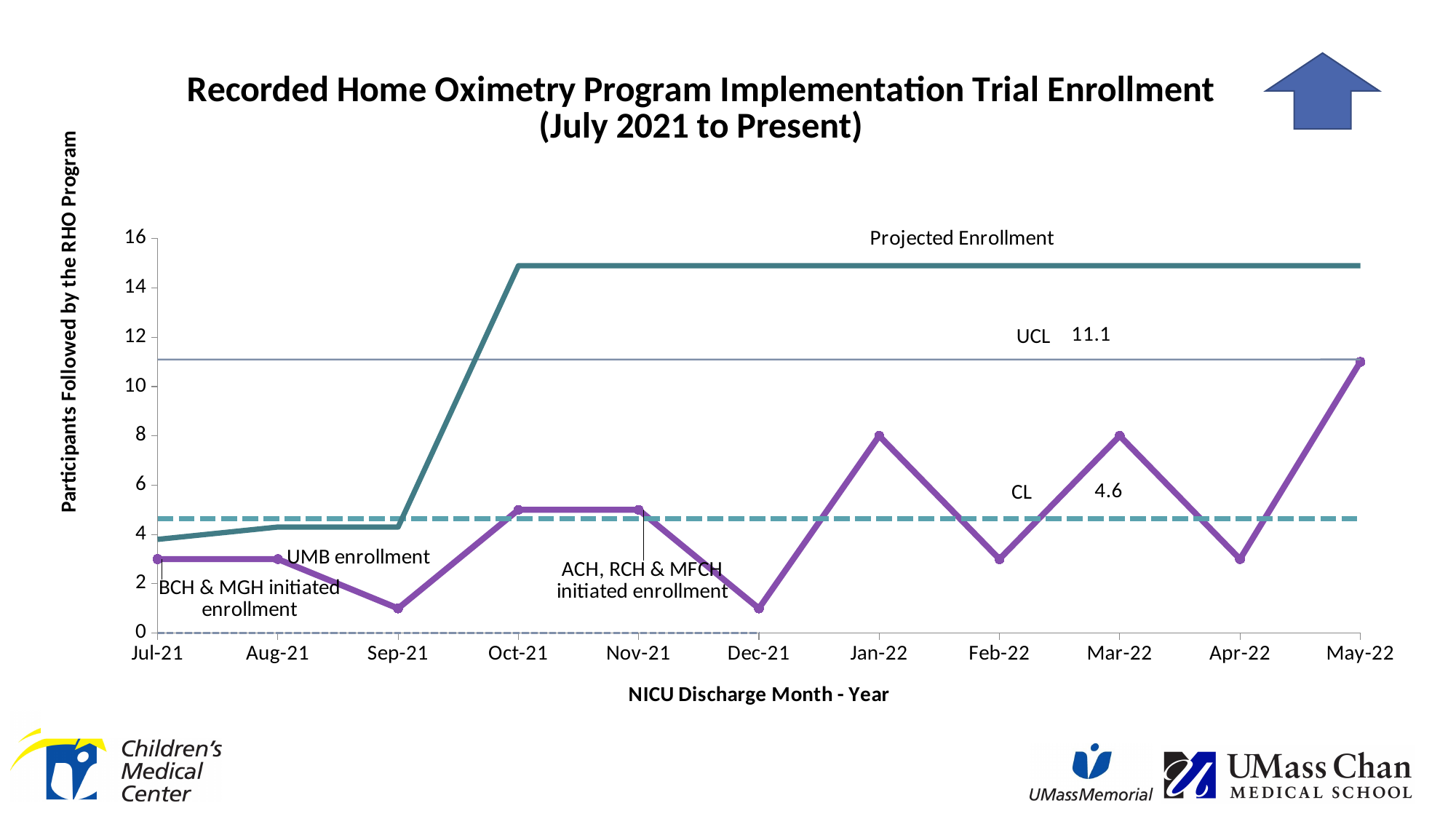
What is the label of the x axis? NICU Discharge Month - Year How many months are shown on the x axis? 11 What kind of chart is shown on the slide? line chart Is the value for Oct-21 greater or less than 4? greater What is the CL value printed on the chart? 4.6 Is the value for Sep-21 greater or less than 2? less How many participants were followed by the RHO Program in Mar-22? 8 How many participants were followed by the RHO Program in Jan-22? 8 What is the UCL value printed on the chart? 11.1 Is the value for May-22 greater or less than 10? greater Which month has more participants followed by the RHO Program, Jan-22 or Feb-22? Jan-22 Which month has the highest number of participants followed by the RHO Program? May-22